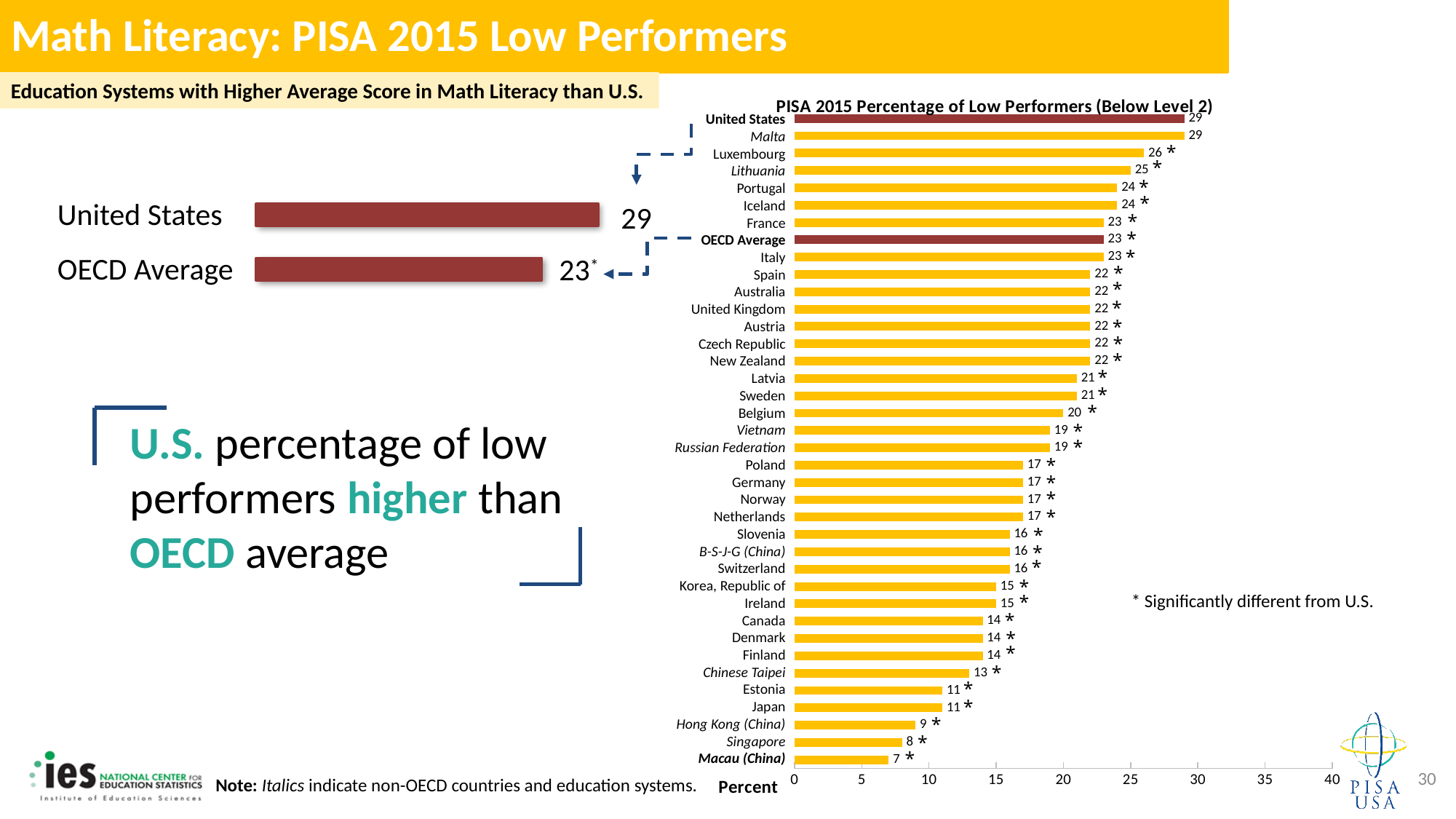
In the chart titled 'PISA 2015 Percentage of Low Performers (Below Level 2)', what is the label on the horizontal axis? Percent In the chart titled 'PISA 2015 Percentage of Low Performers (Below Level 2)', what is the value for Japan? 11 What kind of chart is the 'PISA 2015 Percentage of Low Performers (Below Level 2)' chart? Bar chart In the chart titled 'PISA 2015 Percentage of Low Performers (Below Level 2)', is the value for Belgium greater or less than 15? greater In the chart titled 'PISA 2015 Percentage of Low Performers (Below Level 2)', do the values increase or decrease going from the top bar to the bottom bar? Decrease In the chart titled 'PISA 2015 Percentage of Low Performers (Below Level 2)', which education system has the lowest percentage of low performers? Macau (China) In the chart titled 'PISA 2015 Percentage of Low Performers (Below Level 2)', what is the value for Singapore? 8 In the chart titled 'PISA 2015 Percentage of Low Performers (Below Level 2)', which is larger, the value for Luxembourg or the value for Canada? Luxembourg In the small chart on the left of the slide, what is the value for the OECD Average? 23 In the chart titled 'PISA 2015 Percentage of Low Performers (Below Level 2)', how many education systems (including the OECD Average) are listed? 38 In the chart titled 'PISA 2015 Percentage of Low Performers (Below Level 2)', what is the value for Germany? 17 In the chart titled 'PISA 2015 Percentage of Low Performers (Below Level 2)', what is the difference between the United States value and the Macau (China) value? 22